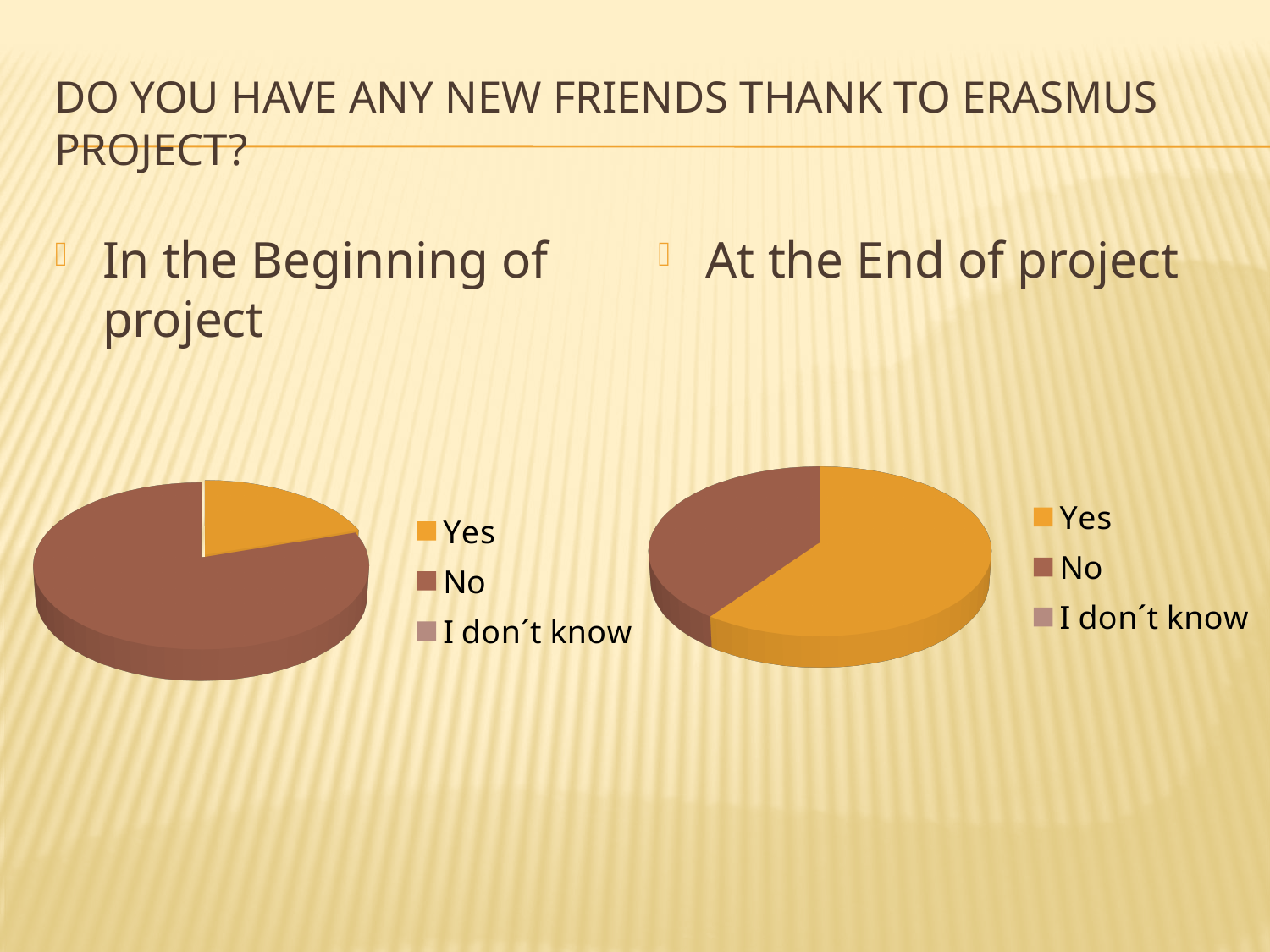
What colour represents the 'Yes' category in the legends of both charts? orange In the 'In the Beginning of project' chart, which category has the largest slice? No In the 'At the End of project' chart, which category has the largest slice? Yes In the 'In the Beginning of project' chart, which is larger, the Yes slice or the No slice? No What kind of chart is the 'At the End of project' chart? pie chart In the 'At the End of project' chart, which is larger, the Yes slice or the No slice? Yes How many entries does the legend of the 'In the Beginning of project' chart list? 3 In the 'At the End of project' chart, is the Yes slice greater or less than half of the pie? greater How many entries does the legend of the 'At the End of project' chart list? 3 In the 'In the Beginning of project' chart, is the Yes slice greater or less than half of the pie? less What kind of chart is the 'In the Beginning of project' chart? pie chart What are the three legend entries shown for the 'At the End of project' chart? Yes, No, I don't know